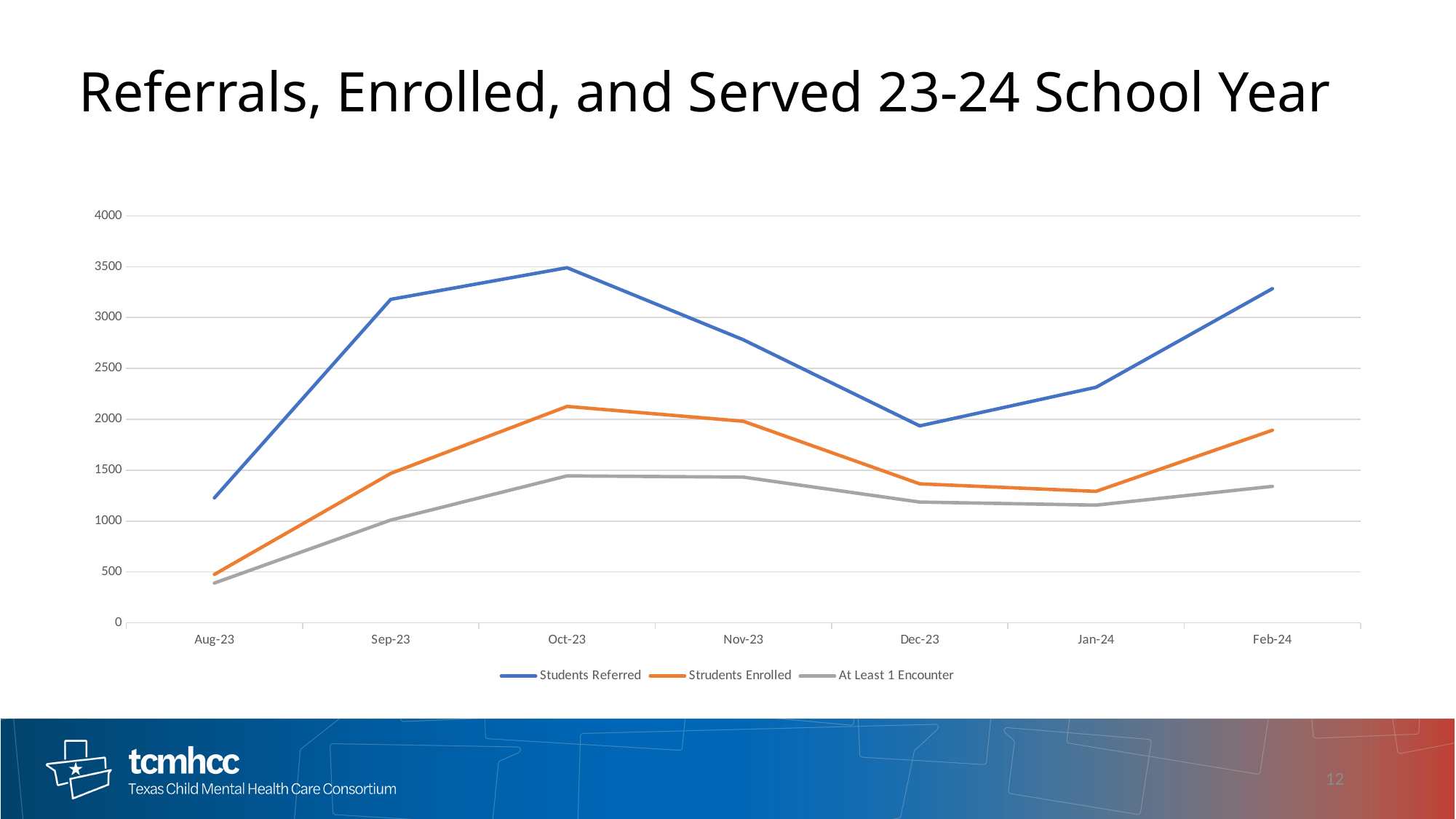
In which month is the Students Referred line at its highest? Oct-23 In which month does the Strudents Enrolled series reach its peak? Oct-23 Is the value for At Least 1 Encounter in Dec-23 greater or less than 1000? greater Is the value for Strudents Enrolled in Aug-23 greater or less than 1000? less In which month is the At Least 1 Encounter series lowest? Aug-23 In which month is the Students Referred line at its lowest? Aug-23 How many months are plotted along the x axis? 7 Is the value for Students Referred in Oct-23 greater or less than 3000? greater Does the Students Referred line rise or fall from Oct-23 to Dec-23? fall How many series does the legend list? 3 What kind of chart is shown on the slide? line chart Which is larger for Students Referred: the value in Nov-23 or the value in Jan-24? Nov-23